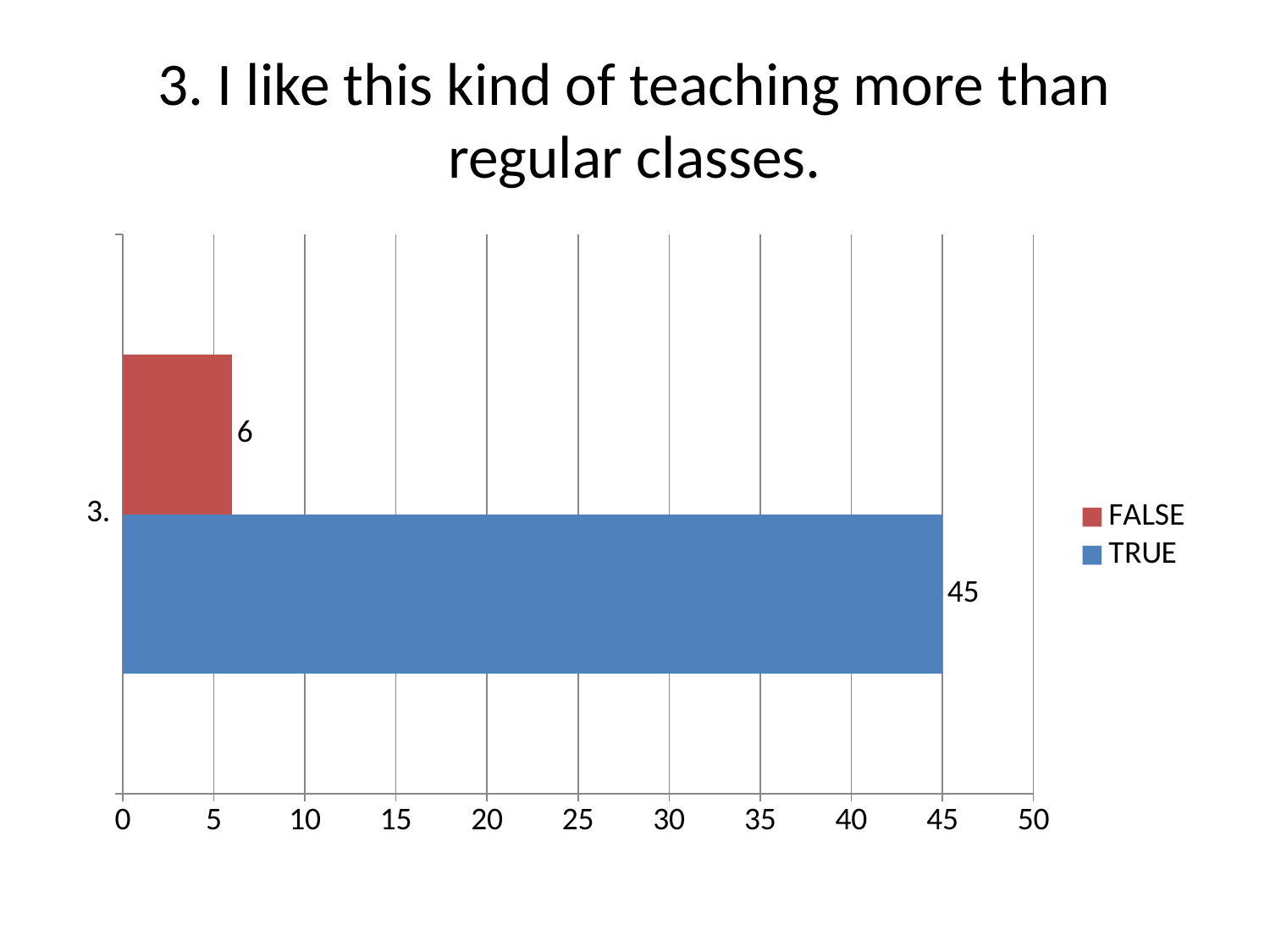
Is the value for TRUE greater or less than 40? greater What kind of chart is shown on the slide? bar chart What colour is the TRUE bar? blue Which series has the higher value, TRUE or FALSE? TRUE Is the value for FALSE greater or less than 10? less What is the title of the slide? 3. I like this kind of teaching more than regular classes. How many series does the legend list? 2 What is the total of the TRUE and FALSE values? 51 Which series has the lowest value? FALSE What is the difference between the TRUE and FALSE values? 39 What is the value for FALSE? 6 What is the value for TRUE? 45